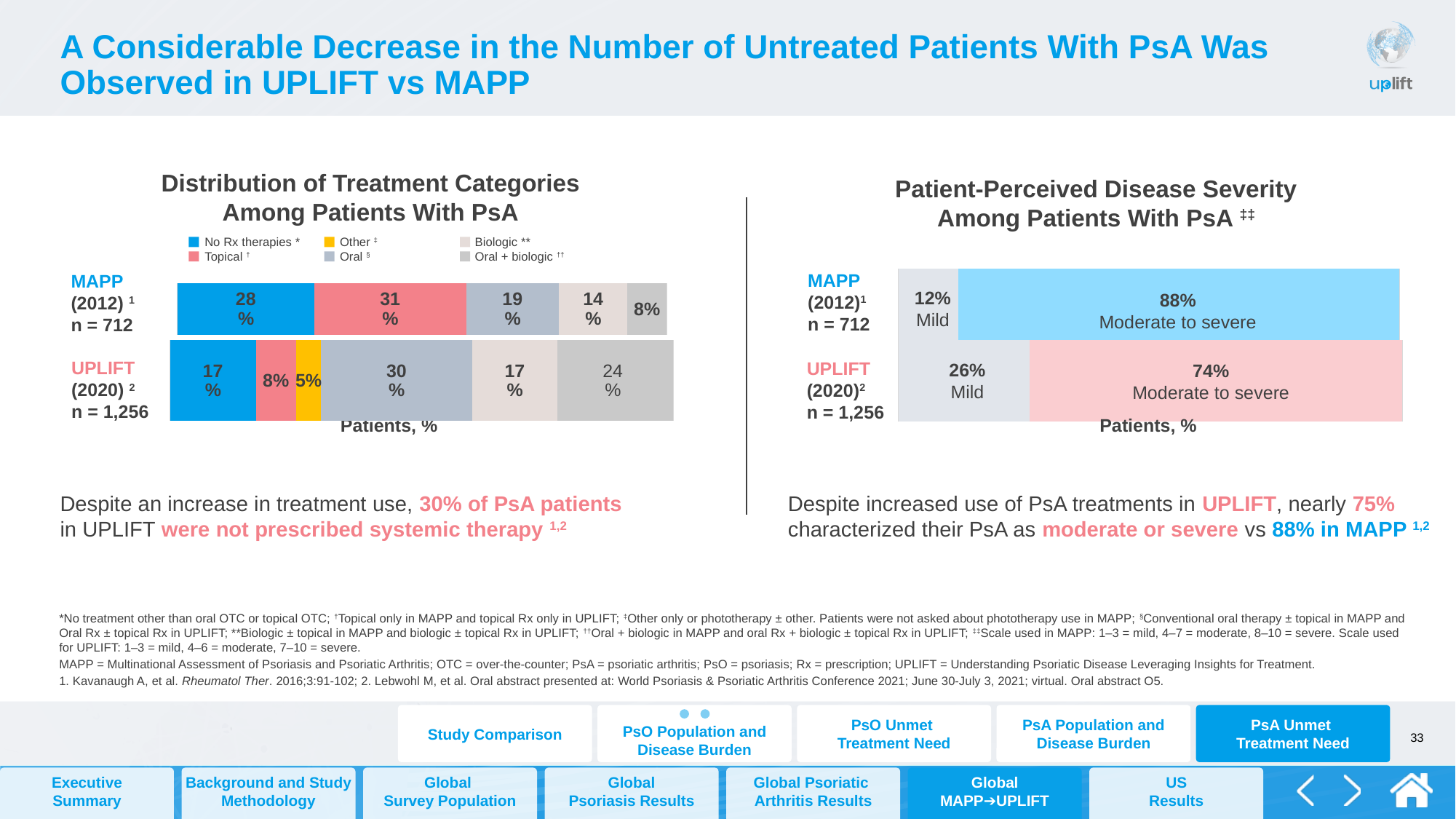
In the 'Distribution of Treatment Categories Among Patients With PsA' chart, which treatment category is the largest for MAPP (2012)? Topical How many series does the legend of the 'Distribution of Treatment Categories Among Patients With PsA' chart list? 6 In the 'Patient-Perceived Disease Severity Among Patients With PsA' chart, what percentage of UPLIFT (2020) patients rated their disease as mild? 26% In the 'Distribution of Treatment Categories Among Patients With PsA' chart, what percentage of UPLIFT (2020) patients were in the 'Other' category? 5% In the 'Patient-Perceived Disease Severity Among Patients With PsA' chart, what percentage of MAPP (2012) patients rated their disease as moderate to severe? 88% In the 'Patient-Perceived Disease Severity Among Patients With PsA' chart, what is the sample size (n) for UPLIFT (2020)? n = 1,256 In the 'Distribution of Treatment Categories Among Patients With PsA' chart, what percentage of MAPP (2012) patients had no Rx therapies? 28% In the 'Distribution of Treatment Categories Among Patients With PsA' chart, which study has the larger oral + biologic percentage, MAPP (2012) or UPLIFT (2020)? UPLIFT (2020) In the 'Patient-Perceived Disease Severity Among Patients With PsA' chart, what is the difference between the moderate to severe percentages for MAPP (2012) and UPLIFT (2020)? 14% What kind of chart is the 'Patient-Perceived Disease Severity Among Patients With PsA' chart? Stacked bar chart In the 'Distribution of Treatment Categories Among Patients With PsA' chart, what percentage of UPLIFT (2020) patients were on oral therapy? 30% In the 'Distribution of Treatment Categories Among Patients With PsA' chart, what is the difference between the topical percentage for MAPP (2012) and for UPLIFT (2020)? 23%